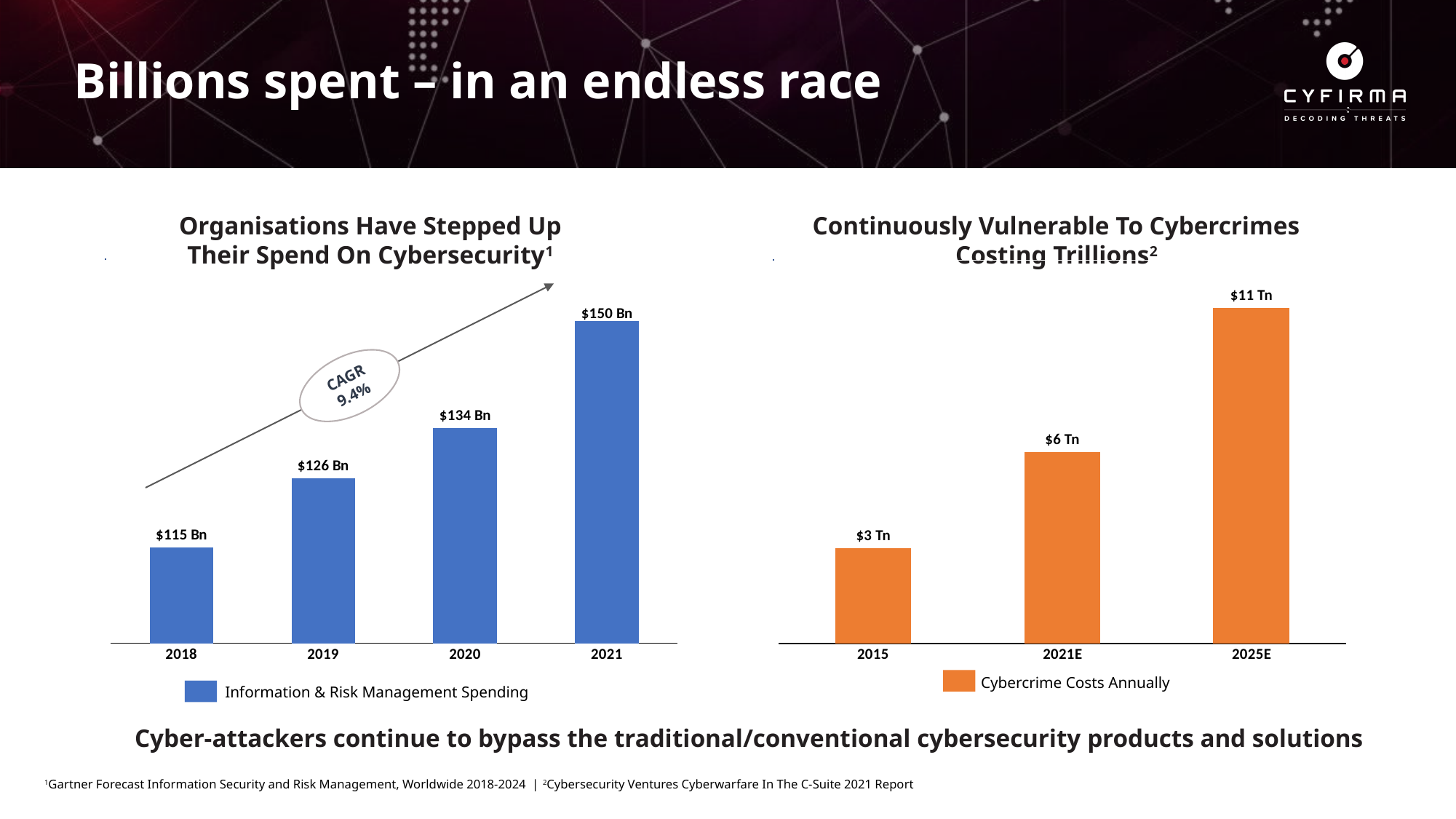
In the right chart (Continuously Vulnerable To Cybercrimes Costing Trillions), which category has the highest value? 2025E What kind of chart is the right chart (Continuously Vulnerable To Cybercrimes Costing Trillions)? bar chart In the left chart (Organisations Have Stepped Up Their Spend On Cybersecurity), do the values rise or fall from 2018 to 2021? rise In the right chart (Continuously Vulnerable To Cybercrimes Costing Trillions), what is the value for 2021E? $6 Tn In the left chart (Organisations Have Stepped Up Their Spend On Cybersecurity), what is the value for 2019? $126 Bn In the right chart (Continuously Vulnerable To Cybercrimes Costing Trillions), what series does the legend list? Cybercrime Costs Annually In the left chart (Organisations Have Stepped Up Their Spend On Cybersecurity), which year has the lowest value? 2018 In the left chart (Organisations Have Stepped Up Their Spend On Cybersecurity), what is the difference between the 2021 and 2018 values? $35 Bn In the right chart (Continuously Vulnerable To Cybercrimes Costing Trillions), what is the difference between the 2025E and 2015 values? $8 Tn In the left chart (Organisations Have Stepped Up Their Spend On Cybersecurity), what is the value for 2021? $150 Bn In the left chart (Organisations Have Stepped Up Their Spend On Cybersecurity), what CAGR is shown? 9.4% In the left chart (Organisations Have Stepped Up Their Spend On Cybersecurity), how many years are shown on the x axis? 4